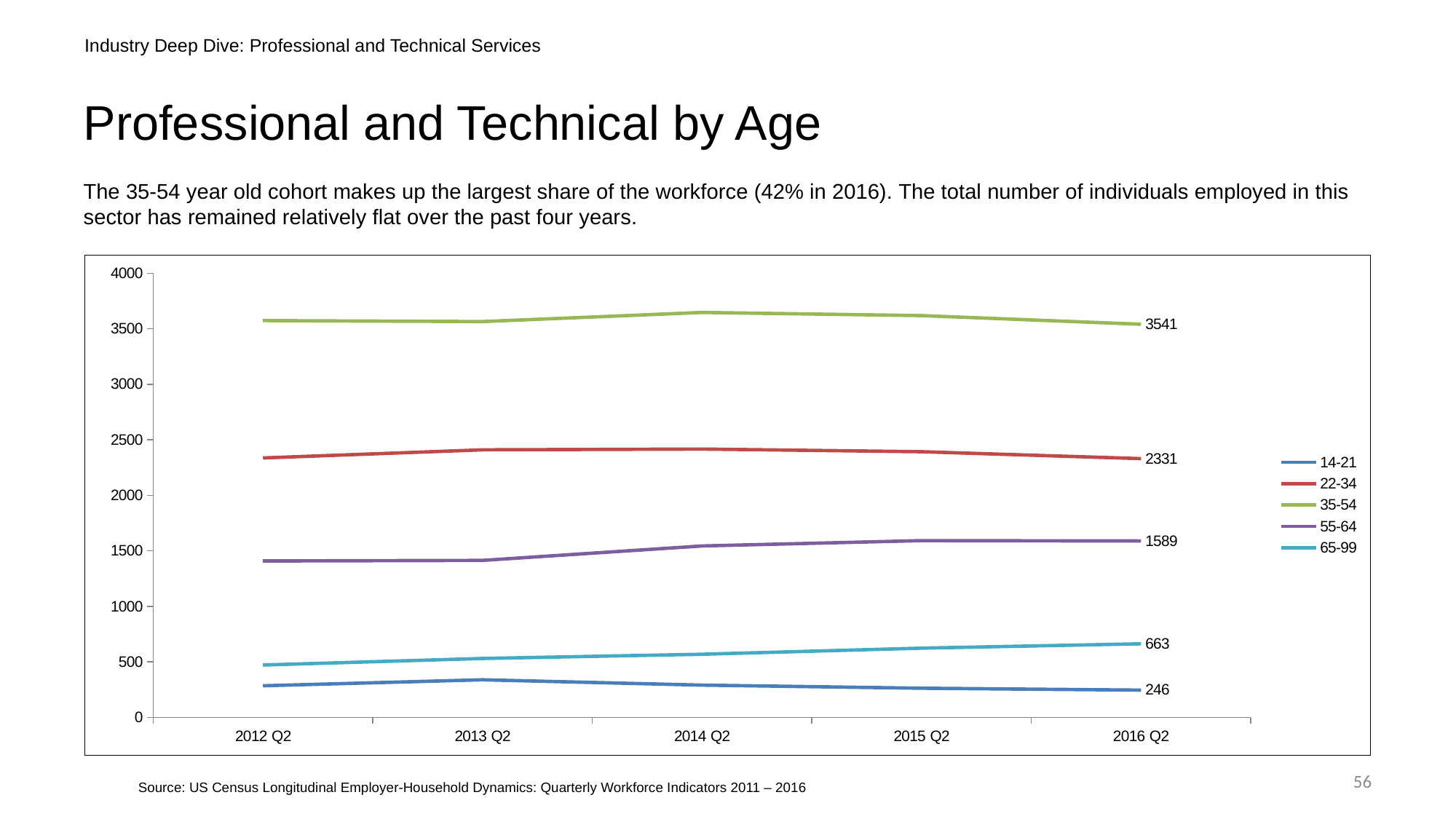
What is the value for the 22-34 series in 2016 Q2? 2331 What is the difference between the 35-54 and 22-34 values in 2016 Q2? 1210 What is the value for the 14-21 series in 2016 Q2? 246 What kind of chart is shown on the slide? line chart What is the value for the 55-64 series in 2016 Q2? 1589 How many series does the legend list? 5 Does the 65-99 series rise or fall from 2012 Q2 to 2016 Q2? rise What is the value for the 35-54 series in 2016 Q2? 3541 Which age group has the highest value in 2016 Q2? 35-54 Which age group has the lowest value in 2016 Q2? 14-21 Is the value for the 55-64 series in 2012 Q2 greater or less than 1500? less What is the value for the 65-99 series in 2016 Q2? 663